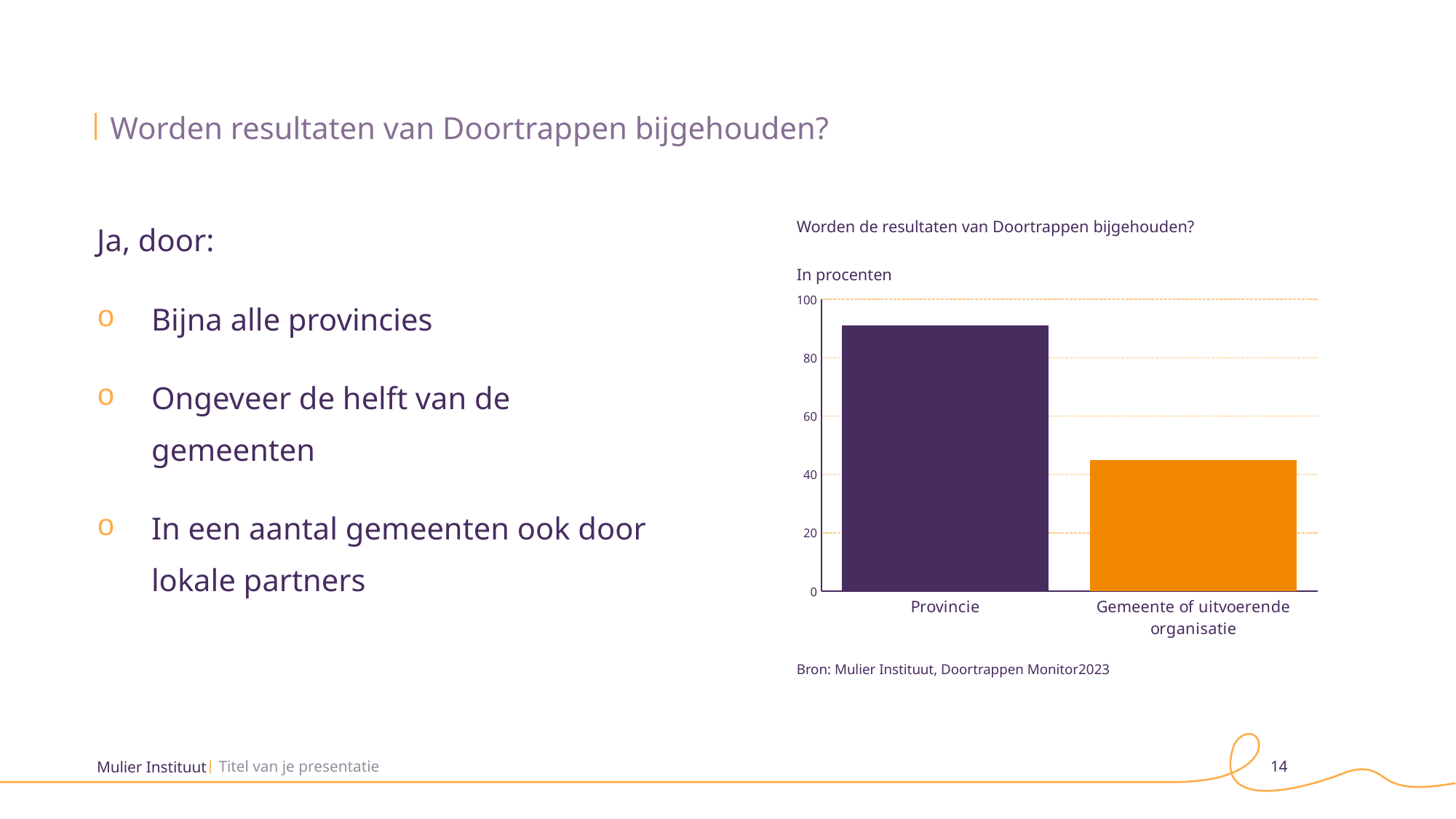
Is the value for Gemeente of uitvoerende organisatie greater or less than 60? less How many categories are shown on the x axis of the chart? 2 Which category has the highest value in the chart? Provincie What unit does the chart say its values are in? In procenten Which is larger: the value for Provincie or the value for Gemeente of uitvoerende organisatie? Provincie Which category has the lowest value in the chart? Gemeente of uitvoerende organisatie What kind of chart is shown on the slide? bar chart Is the value for Provincie greater or less than 100? less Is the value for Provincie greater or less than 80? greater What is the title of the chart? Worden de resultaten van Doortrappen bijgehouden?